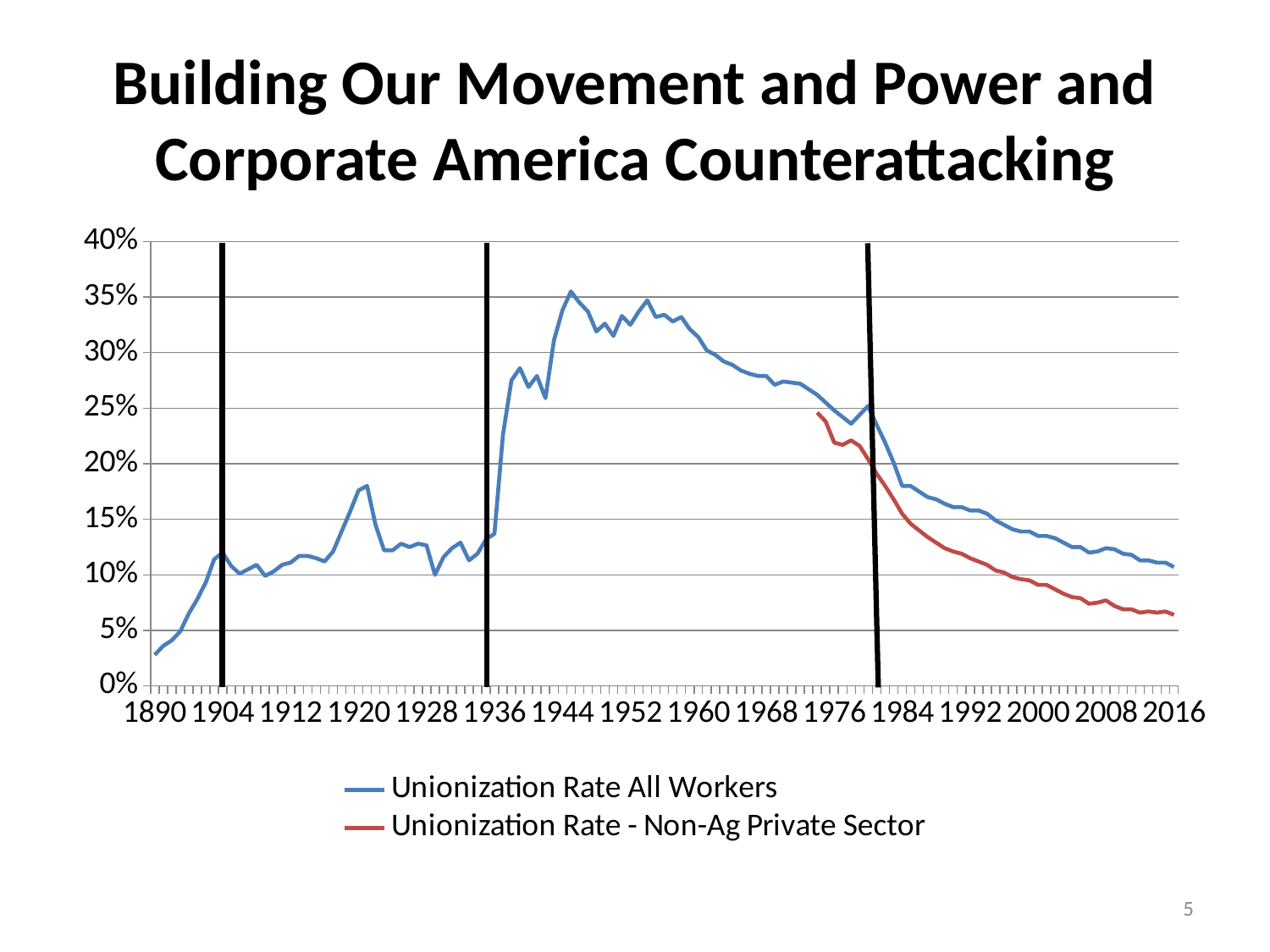
Is the value for Unionization Rate All Workers in 1944 greater or less than 30%? greater In 2016, which series has the higher value, Unionization Rate All Workers or Unionization Rate - Non-Ag Private Sector? Unionization Rate All Workers How many vertical black lines are drawn on the chart? 3 Which series is shown in red in the legend? Unionization Rate - Non-Ag Private Sector Does the Unionization Rate All Workers line rise or fall between 1984 and 2016? fall How many series does the legend list? 2 Does the Unionization Rate All Workers line rise or fall between 1890 and 1904? rise Is the value for Unionization Rate - Non-Ag Private Sector in 1976 greater or less than 20%? greater Is the value for Unionization Rate All Workers in 2016 greater or less than 15%? less What kind of chart is shown on the slide? line chart